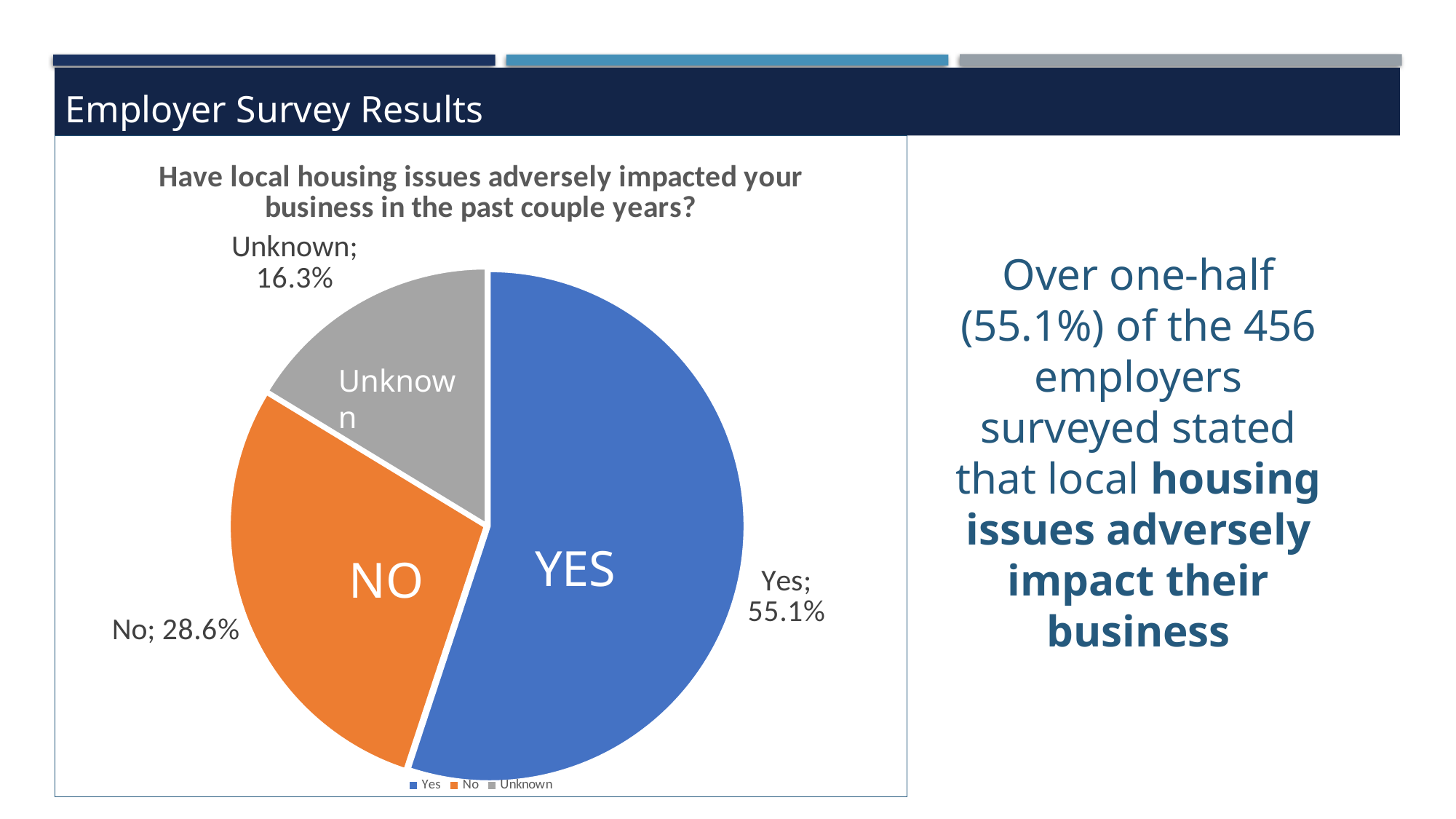
Which response has the smallest share of the pie? Unknown What percentage of employers answered No? 28.6% Which response has the largest share of the pie? Yes How many slices does the pie chart have? 3 What is the difference in percentage points between the Yes and No slices? 26.5 What percentage of employers answered Yes? 55.1% What is the title of the chart? Have local housing issues adversely impacted your business in the past couple years? How many entries does the legend list? 3 What colour is the No slice? Orange Which slice is larger, No or Unknown? No What share of the pie is the Unknown slice? 16.3% What kind of chart is shown on the slide? Pie chart